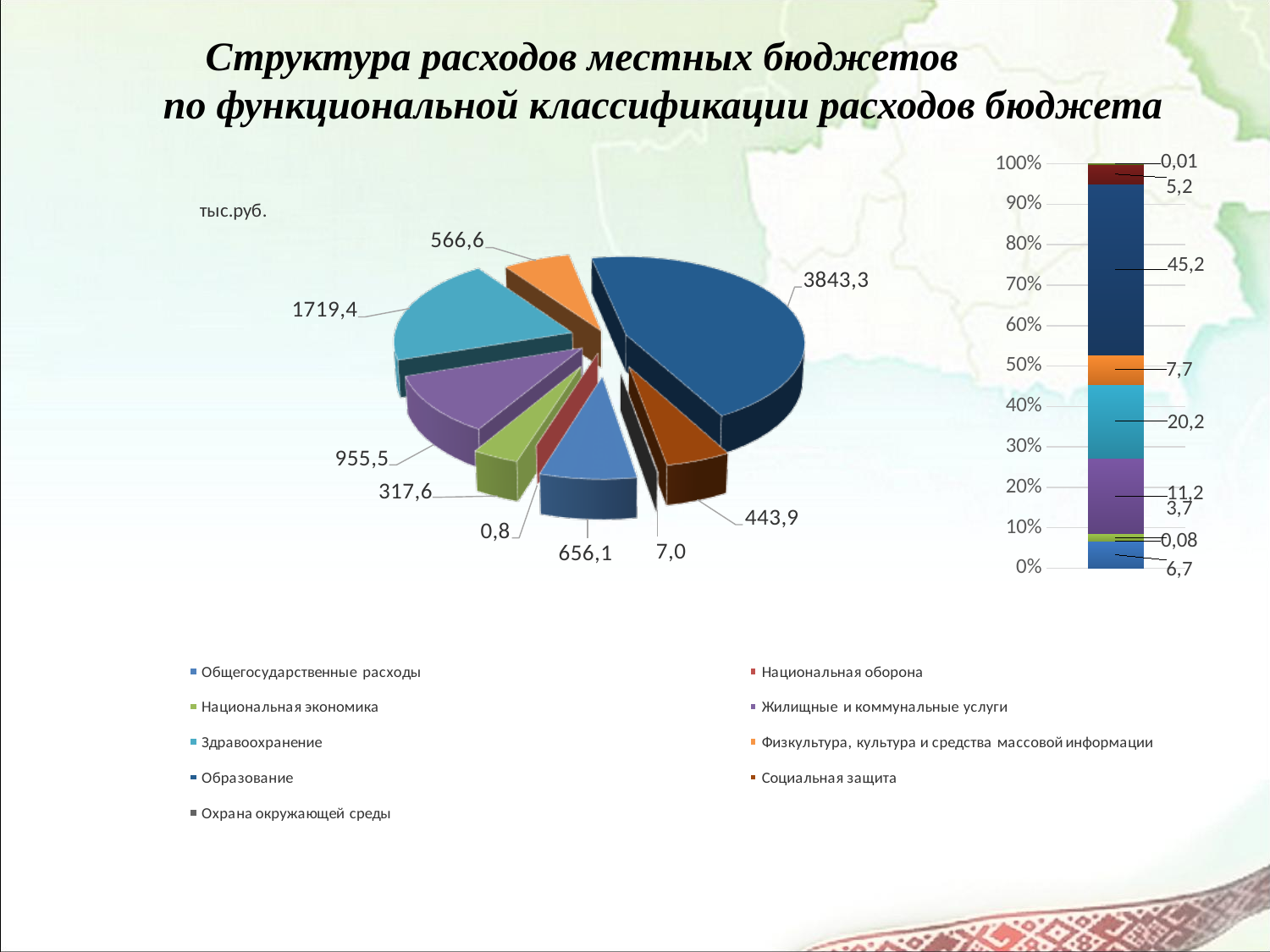
In the pie chart, which is larger: the slice labelled 656,1 or the slice labelled 443,9? 656,1 In the pie chart, what is the value for Жилищные и коммунальные услуги (the purple slice)? 955,5 What kind of chart is the chart on the left of the slide? pie chart In the pie chart, what is the value for Физкультура, культура и средства массовой информации (the orange slice)? 566,6 In the stacked bar on the right, what is the percentage value of the largest (dark blue) segment? 45,2 In the pie chart, what is the value of the smallest slice? 0,8 How many categories does the legend list? 9 In the stacked bar on the right, what is the value of the teal segment? 20,2 What unit is shown next to the pie chart? тыс.руб. In the pie chart, what is the difference between the largest slice (3843,3) and the teal slice (1719,4)? 2123,9 In the pie chart, what is the value of the largest slice? 3843,3 In the pie chart, what is the value for Здравоохранение (the teal slice)? 1719,4